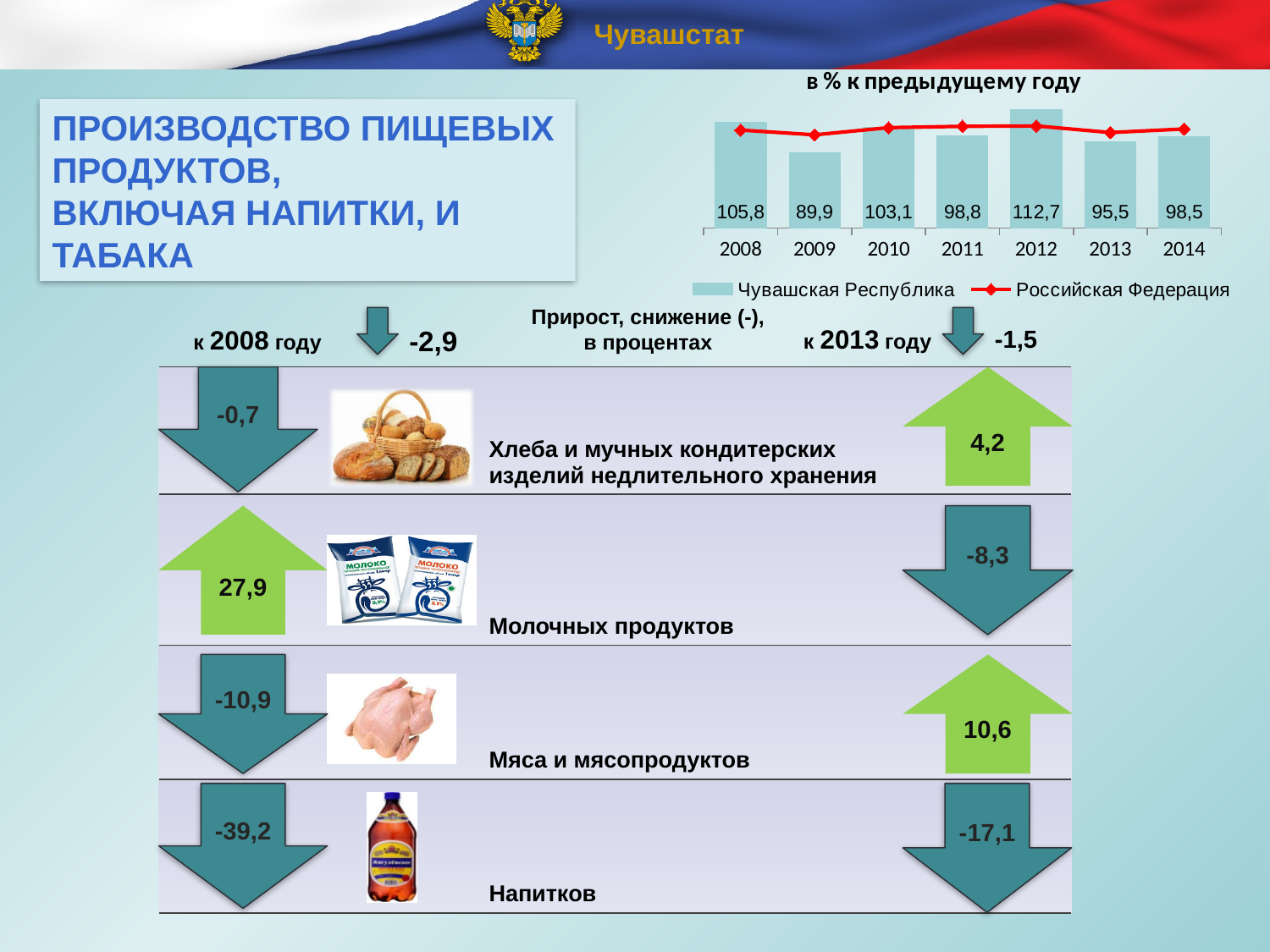
Which year has the larger Чувашская Республика value, 2010 or 2011? 2010 What is the value for Чувашская Республика in 2012? 112,7 What is the value for Чувашская Республика in 2009? 89,9 How many years are shown on the x axis of the chart? 7 What is the difference between the Чувашская Республика values for 2008 and 2014? 7,3 What kind of chart is shown at the top right of the slide? Bar chart with a line What is the difference between the Чувашская Республика values for 2012 and 2013? 17,2 How many series does the chart legend list? 2 In which year is the Чувашская Республика bar lowest? 2009 In which year is the Чувашская Республика bar highest? 2012 What is the value for Чувашская Республика in 2014? 98,5 Do the Чувашская Республика values rise or fall from 2012 to 2014? Fall